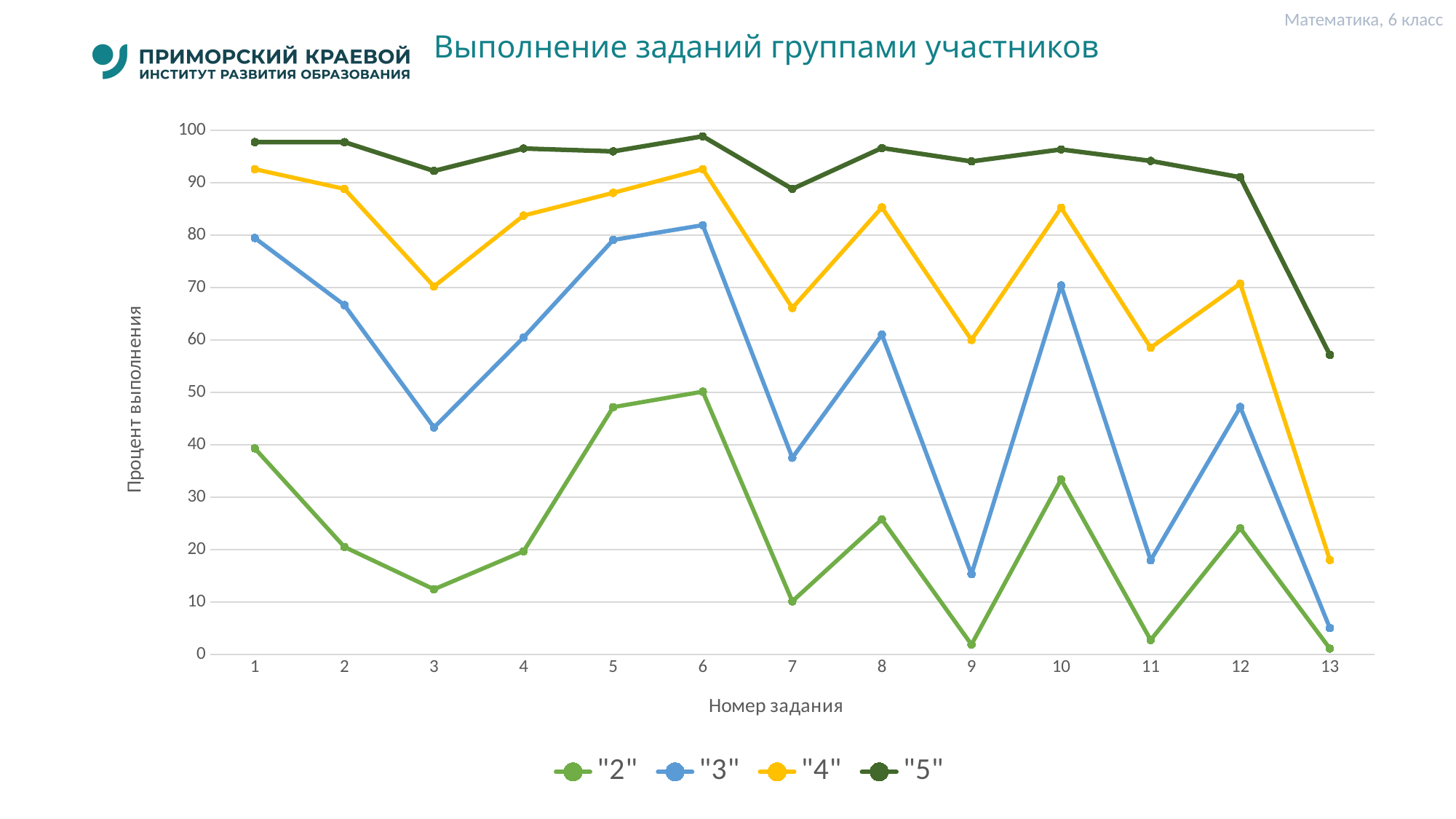
At which task number does series "4" reach its lowest value? 13 At task 10, which series has the larger value, "2" or "3"? "3" Is the value for series "3" at task 10 greater or less than 60? greater What kind of chart is shown on the slide? line chart How many series does the legend list? 4 Does the value for series "5" rise or fall from task 12 to task 13? fall Is the value for series "5" at task 13 greater or less than 60? less Is the value for series "2" at task 1 greater or less than 30? greater How many task numbers are plotted along the x axis? 13 What is the title of the y axis? Процент выполнения At which task number does series "3" reach its lowest value? 13